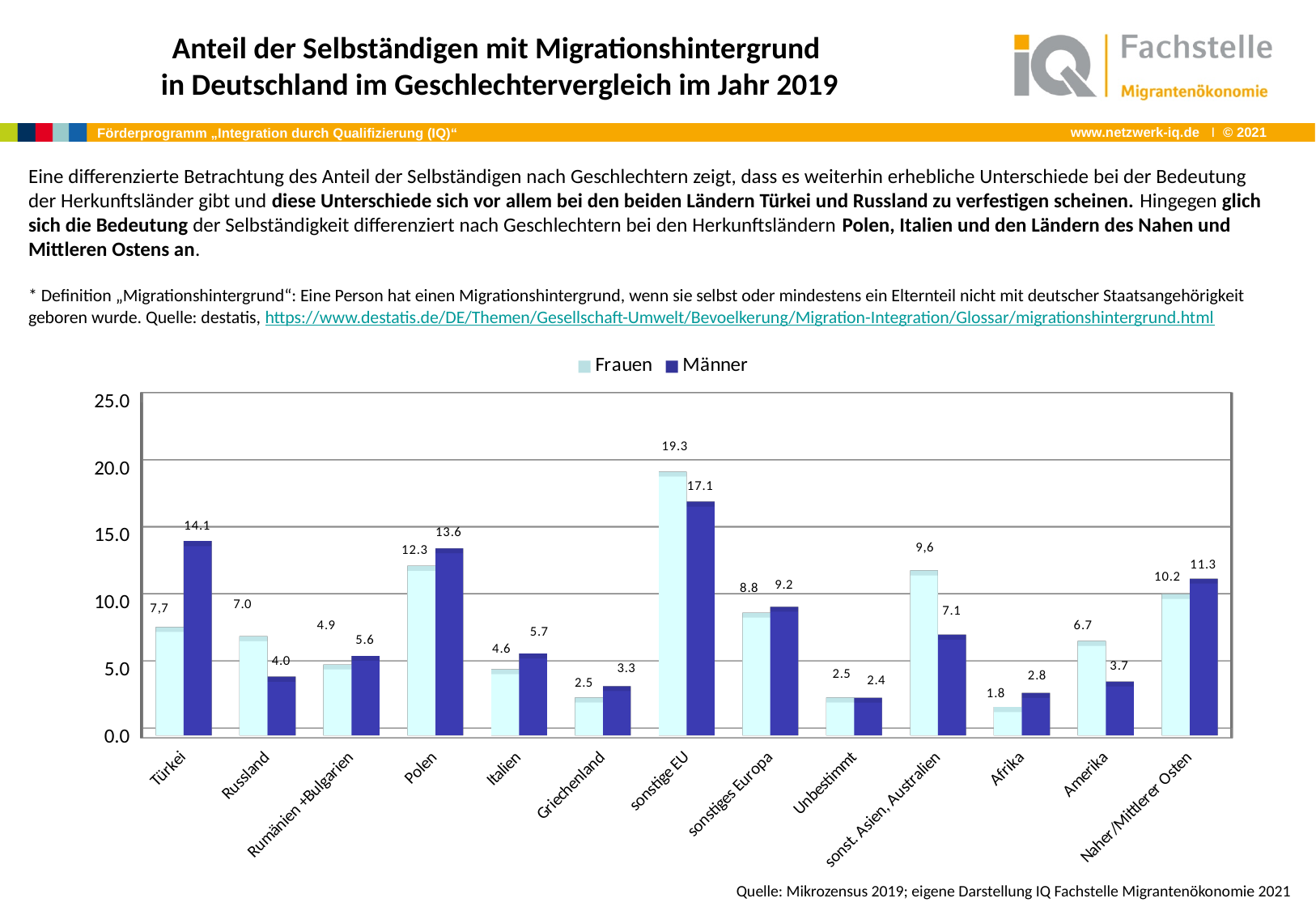
Which category has the lowest value for Frauen? Afrika What is the value for Männer in the Türkei category? 14.1 What is the value for Frauen in the Amerika category? 6.7 What is the value for Frauen in the sonstige EU category? 19.3 Is the value for Frauen in the Polen category greater or less than 10.0? greater How many categories are shown on the x axis? 13 Which series is shown in dark blue in the legend? Männer Which category has the highest value for Männer? sonstige EU What kind of chart is shown on the slide? bar chart For Russland, which is larger, the Frauen value or the Männer value? Frauen What is the difference between the Männer and Frauen values for Türkei? 6.4 How many series does the legend list? 2